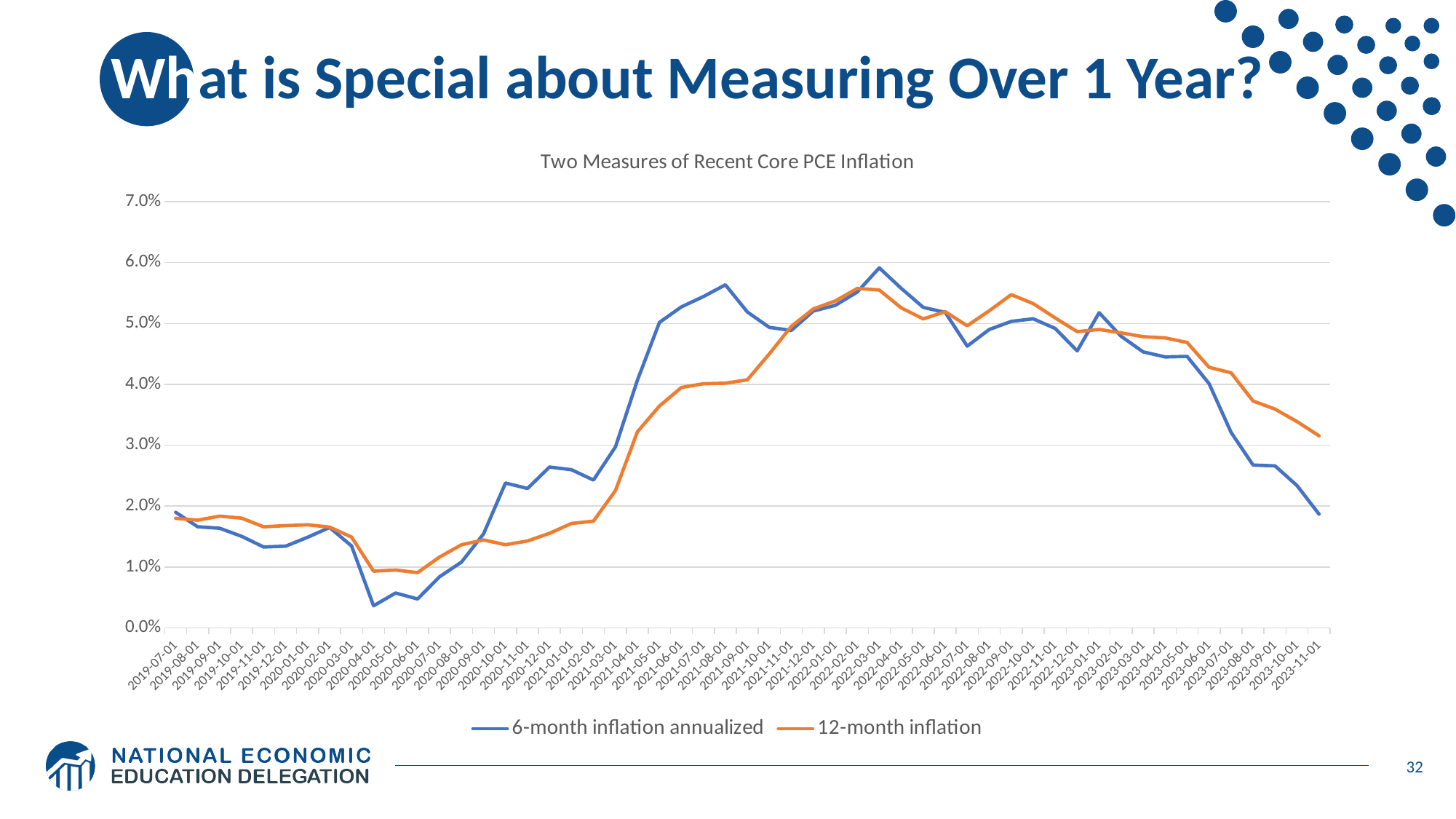
Is the value of 6-month inflation annualized at 2020-04-01 greater or less than 1.0%? less Does the 6-month inflation annualized series rise or fall from 2023-05-01 to 2023-11-01? Fall Is the value of 12-month inflation at 2023-11-01 greater or less than 3.0%? greater What kind of chart is shown on the slide? Line chart Is the value of 6-month inflation annualized at 2023-11-01 greater or less than 2.0%? less How many monthly dates are shown on the x axis? 53 What is the title of the chart? Two Measures of Recent Core PCE Inflation Which colour is used for the 12-month inflation line? Orange How many series does the legend list? 2 At 2021-05-01, which series has the higher value: 6-month inflation annualized or 12-month inflation? 6-month inflation annualized At which date does the 6-month inflation annualized series reach its highest value? 2022-03-01